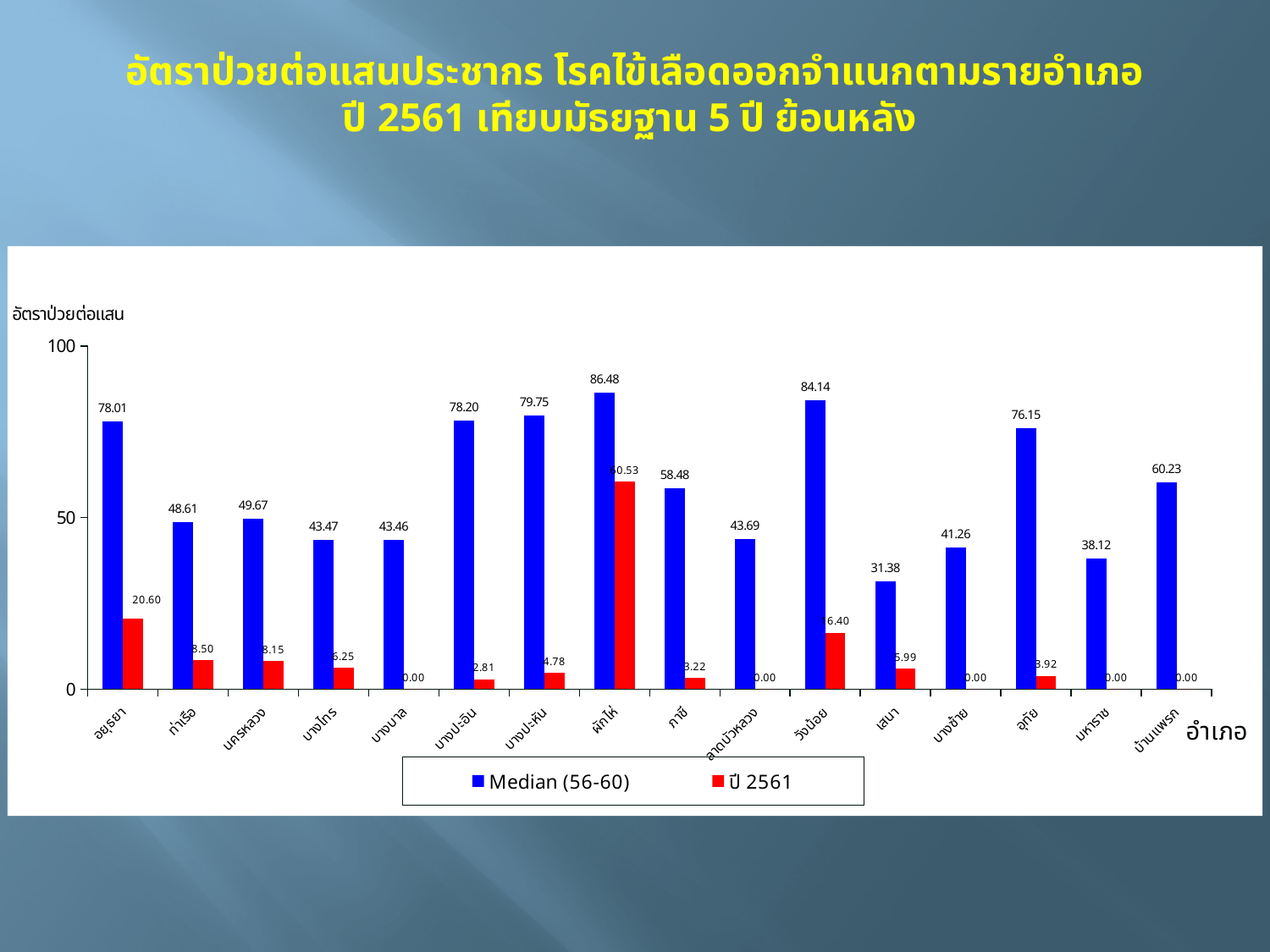
What is the Median (56-60) value for วังน้อย? 84.14 Which district has the highest Median (56-60) value? ผักไห่ What is the Median (56-60) value for อยุธยา? 78.01 Which district has the lowest Median (56-60) value? เสนา What is the difference between the Median (56-60) and ปี 2561 values for อยุธยา? 57.41 What is the ปี 2561 value for อยุธยา? 20.60 How many districts are shown on the x axis? 16 Which has a larger Median (56-60) value, อุทัย or มหาราช? อุทัย Which district has the highest ปี 2561 value? ผักไห่ How many series does the legend list? 2 Is the ปี 2561 value for ผักไห่ greater or less than 50? greater What kind of chart is shown on the slide? bar chart